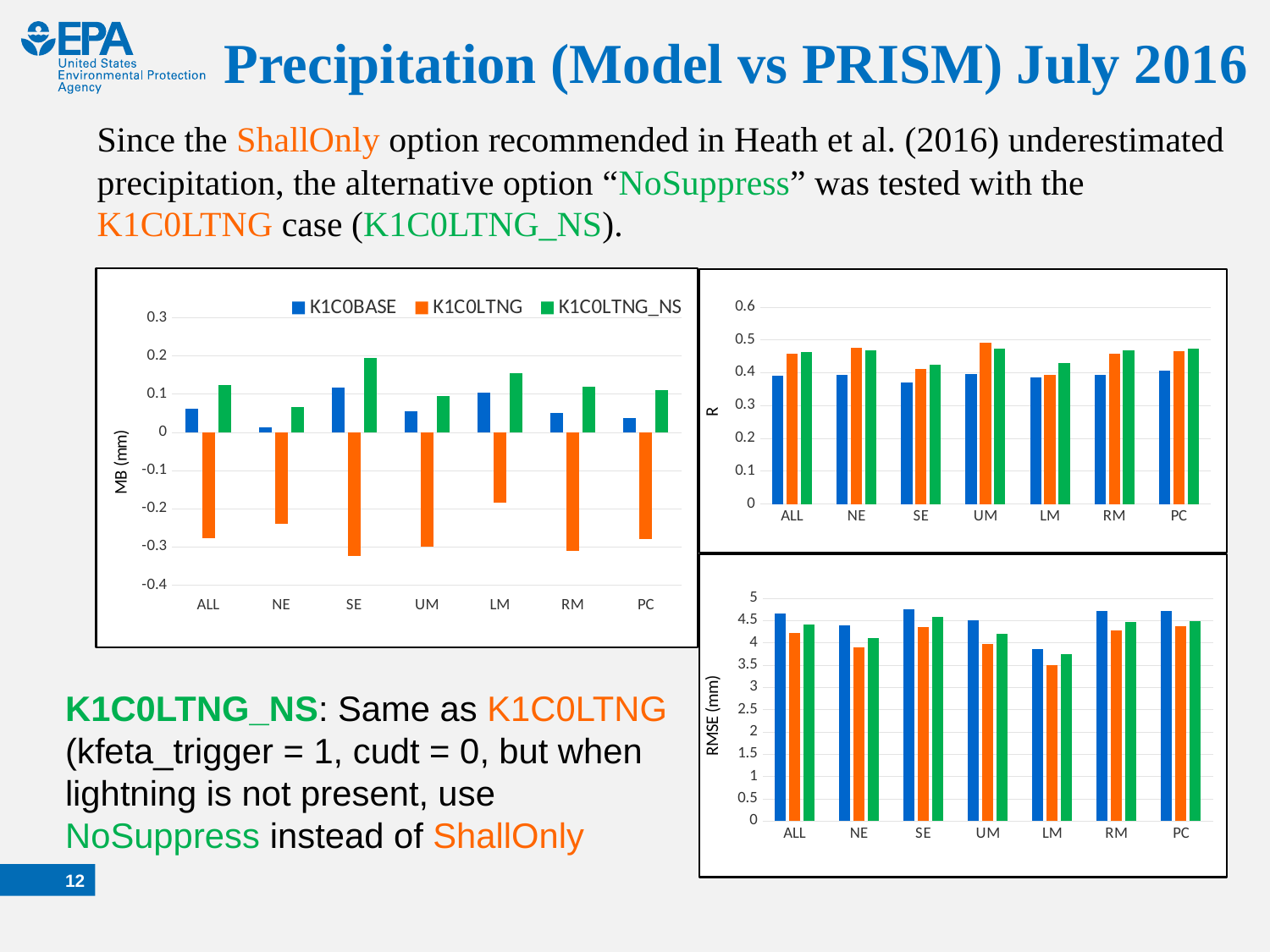
In the RMSE (mm) chart at the bottom right, which category has the lowest K1C0LTNG value? LM In the MB (mm) chart, which is larger for ALL: K1C0BASE or K1C0LTNG_NS? K1C0LTNG_NS In the R chart at the top right, which category has the lowest K1C0BASE value? SE In the MB (mm) chart, is the K1C0LTNG value for LM greater or less than -0.1? less How many series does the legend of the MB (mm) chart list? 3 What kind of chart is the MB (mm) chart on the left of the slide? bar chart In the MB (mm) chart, is the K1C0LTNG_NS value for SE greater or less than 0.1? greater In the RMSE (mm) chart at the bottom right, is the K1C0BASE value for LM greater or less than 4? less How many categories are shown on the x axis of the MB (mm) chart? 7 In the RMSE (mm) chart at the bottom right, which is larger for ALL: K1C0BASE or K1C0LTNG? K1C0BASE In the MB (mm) chart, which category has the highest K1C0LTNG_NS value? SE